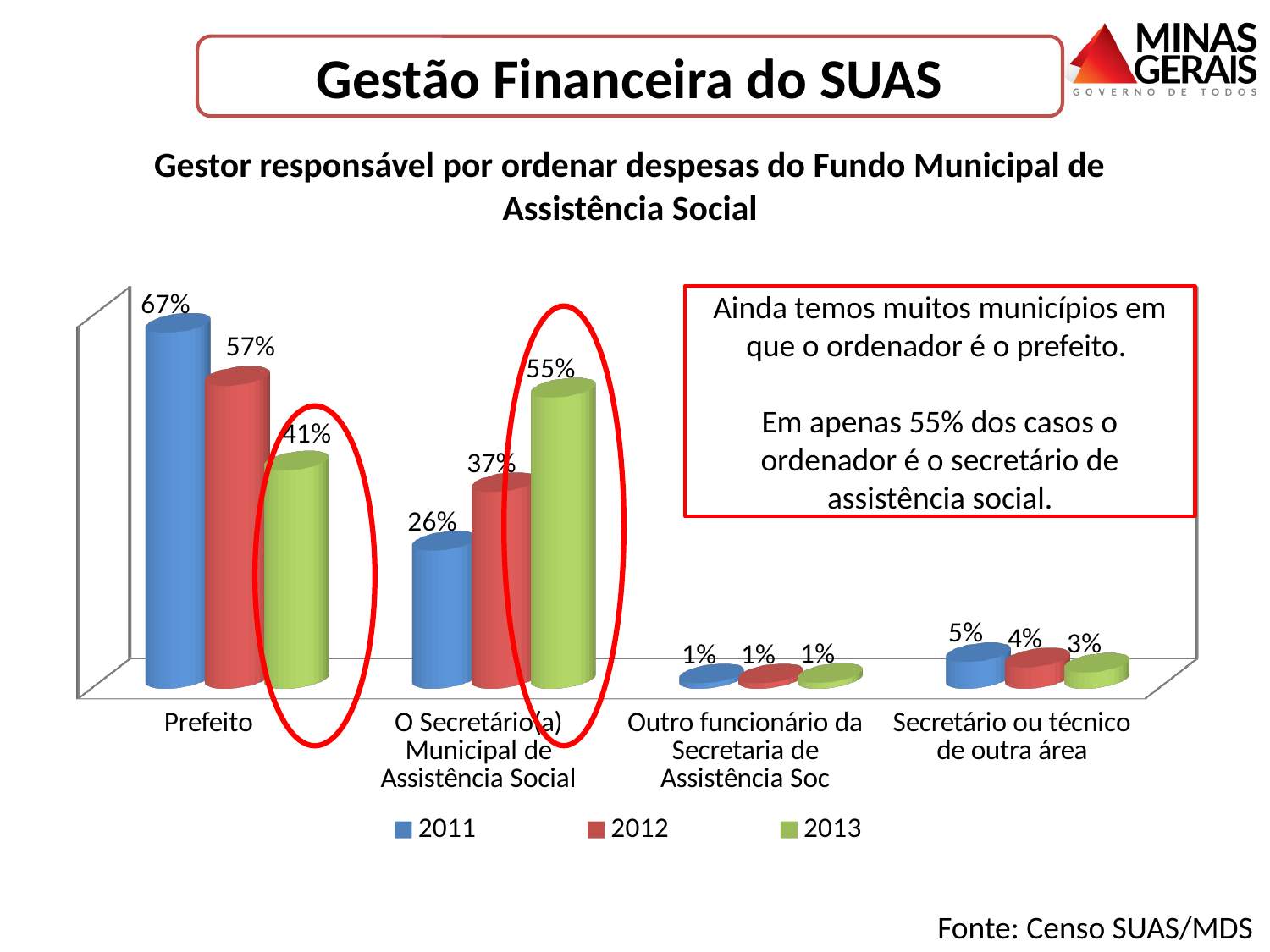
Do the values for Prefeito rise or fall from 2011 to 2013? Fall Which category has the highest value in 2011? Prefeito What is the value for O Secretário(a) Municipal de Assistência Social in 2013? 55% How many categories are shown on the x axis? 4 What is the value for Prefeito in 2011? 67% How many series does the legend list? 3 Which is larger in 2013: Prefeito or O Secretário(a) Municipal de Assistência Social? O Secretário(a) Municipal de Assistência Social What is the value for Prefeito in 2013? 41% Which category has the lowest value in 2013? Outro funcionário da Secretaria de Assistência Soc What is the value for Secretário ou técnico de outra área in 2012? 4% What kind of chart is shown on the slide? Bar chart What is the difference between the 2011 and 2013 values for Prefeito? 26%